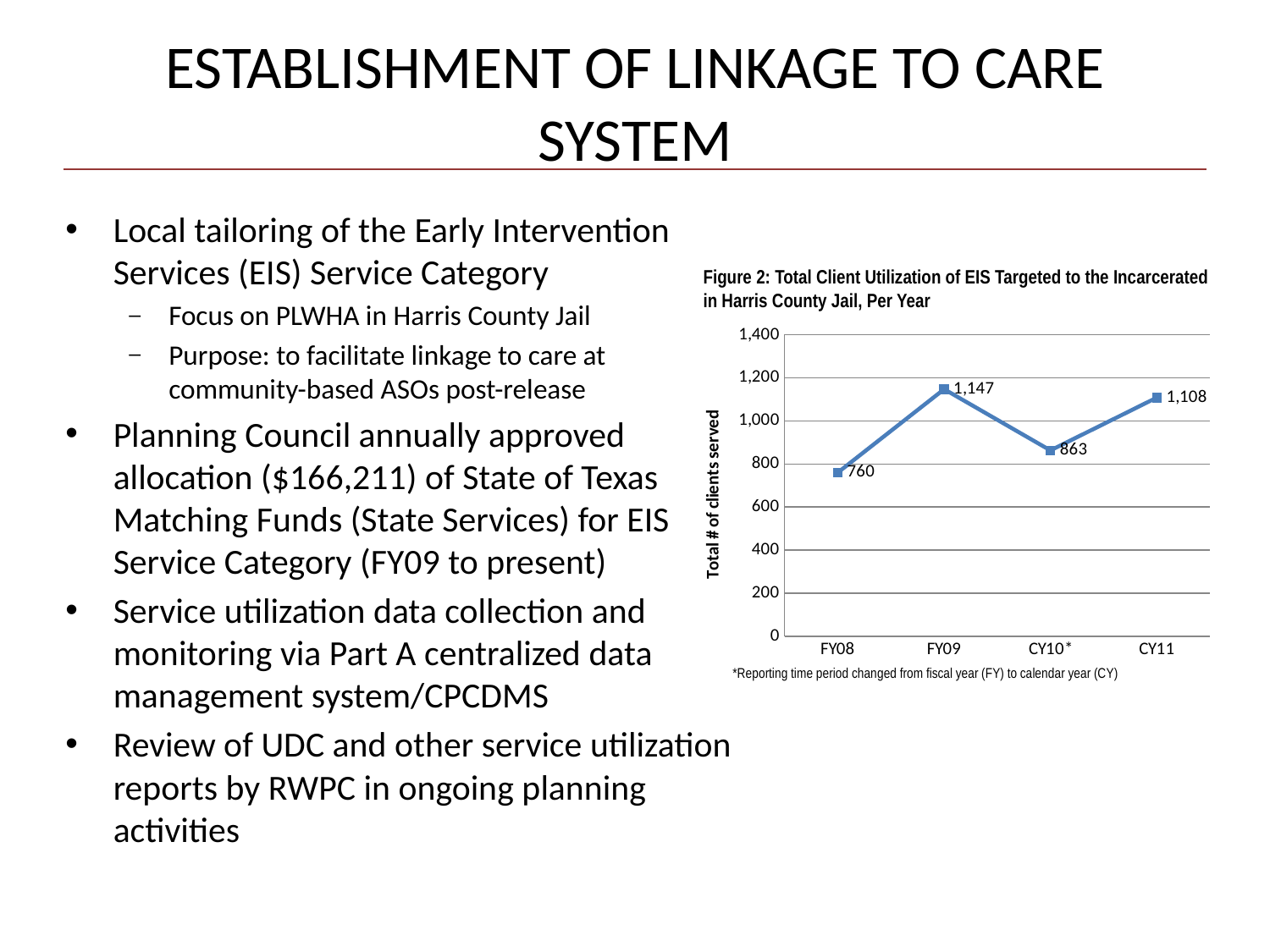
Which period had more clients served, CY10* or CY11? CY11 How many time periods are plotted on the chart? 4 Which period has the highest number of clients served? FY09 What is the total number of clients served in CY11? 1,108 What kind of chart is shown on the slide? Line chart What is the difference in clients served between FY09 and CY10*? 284 What is the total number of clients served in FY09? 1,147 What is the total number of clients served in FY08? 760 Did the number of clients served rise or fall from FY08 to FY09? Rise Which period has the lowest number of clients served? FY08 What is the label of the vertical axis of the chart? Total # of clients served Is the value for CY10* greater or less than 1,000? less